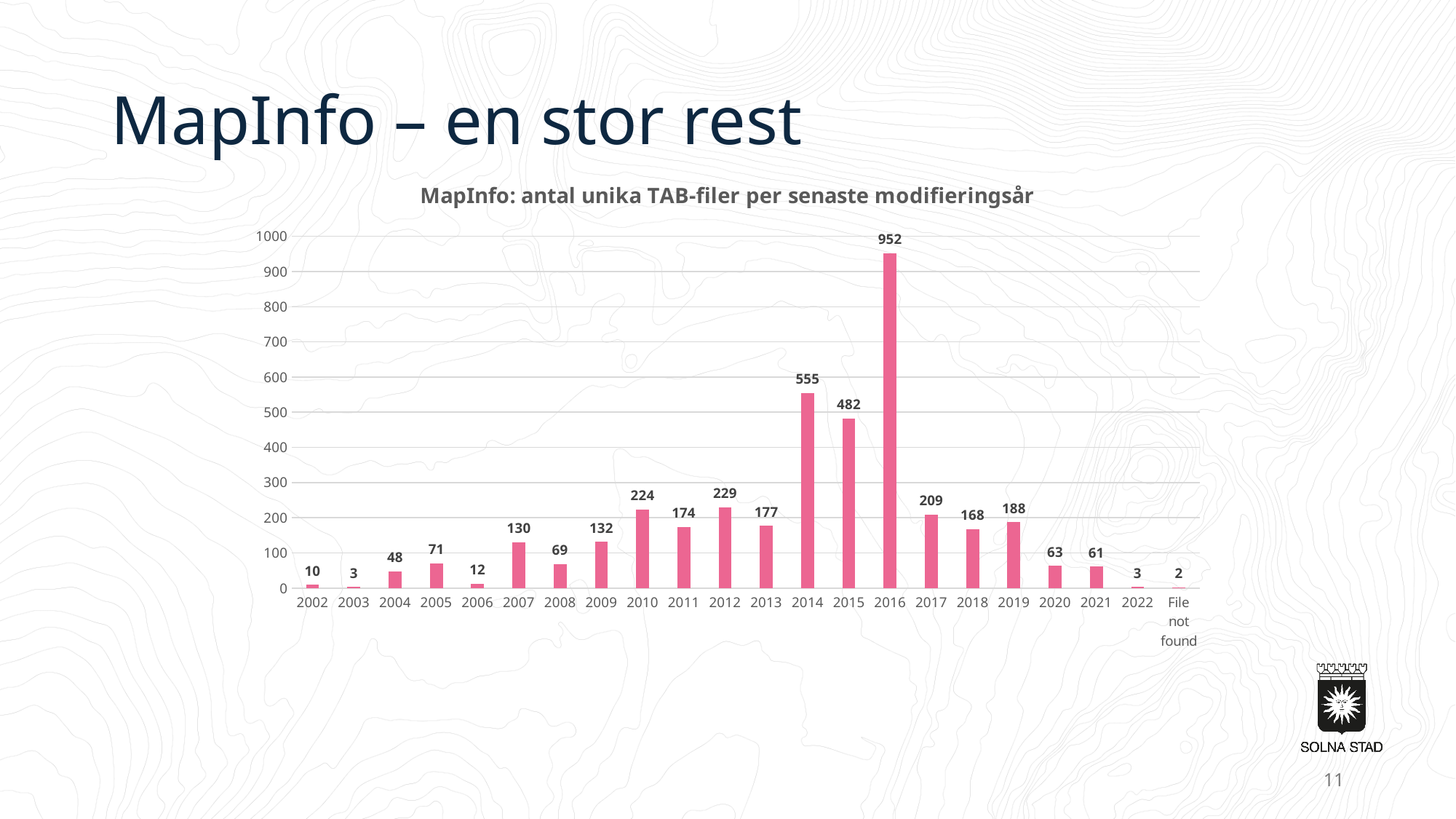
What is the value for 2016? 952 Is the value for 2016 greater or less than 900? greater How many categories are shown on the x axis? 22 What is the value for the 'File not found' category? 2 What is the title of the chart? MapInfo: antal unika TAB-filer per senaste modifieringsår Which category has the lowest value? File not found What kind of chart is shown on the slide? bar chart Which is larger, the value for 2010 or the value for 2012? 2012 Which category has the highest value? 2016 What is the difference between the values for 2014 and 2015? 73 Do the values rise or fall from 2016 to 2022? fall What is the value for 2014? 555